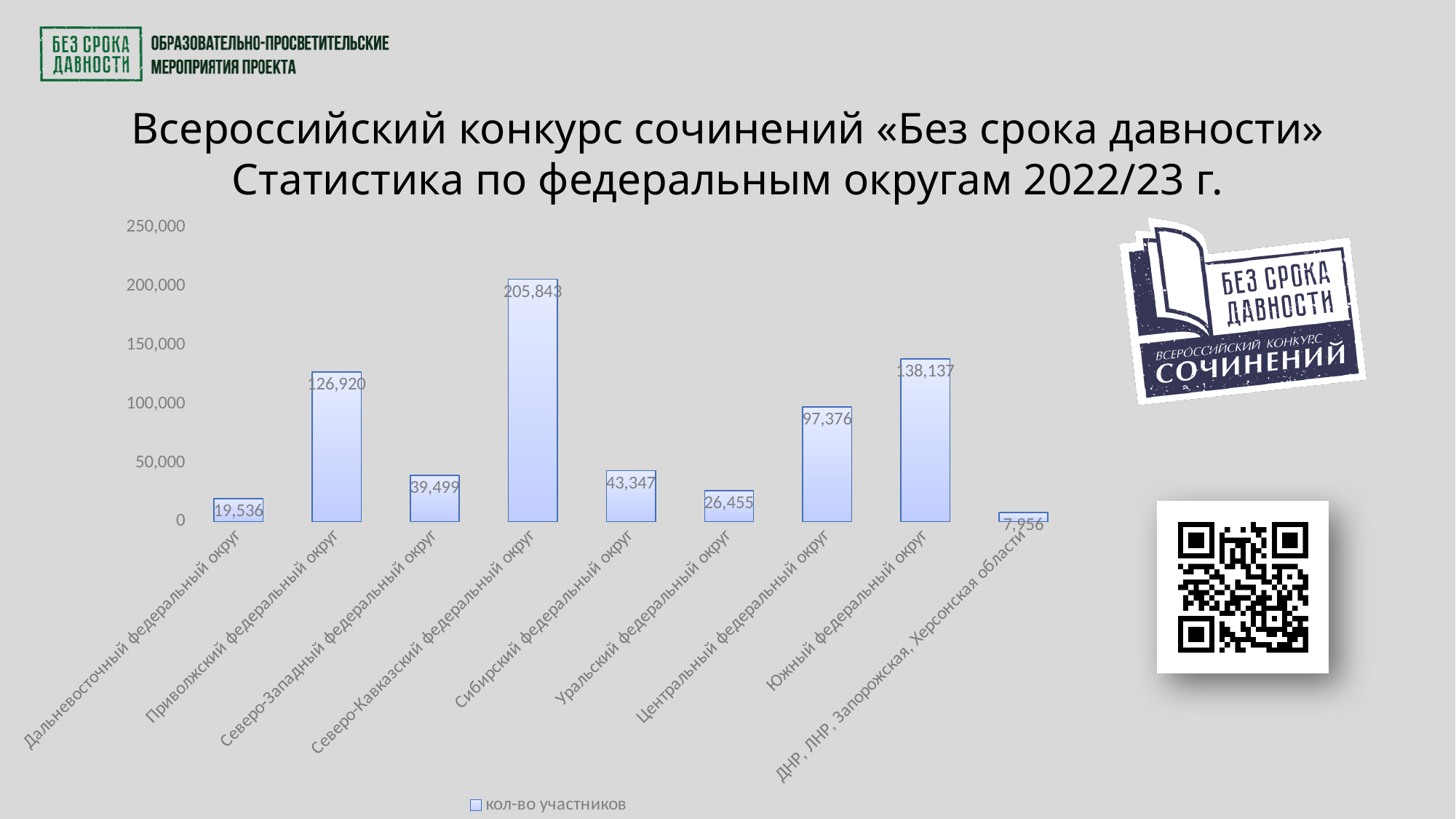
What is the difference between the values for Северо-Кавказский федеральный округ and Южный федеральный округ? 67,706 How many categories are shown on the x axis? 9 Which category has the lowest value? ДНР, ЛНР, Запорожская, Херсонская области What kind of chart is shown on the slide? bar chart What is the difference between the values for Приволжский федеральный округ and Центральный федеральный округ? 29,544 Which category has the highest value? Северо-Кавказский федеральный округ How many series does the legend list? 1 What is the value for Северо-Кавказский федеральный округ? 205,843 What is the value for Приволжский федеральный округ? 126,920 Is the value for Южный федеральный округ greater or less than 100,000? greater Which is larger, the value for Сибирский федеральный округ or Уральский федеральный округ? Сибирский федеральный округ What is the value for ДНР, ЛНР, Запорожская, Херсонская области? 7,956